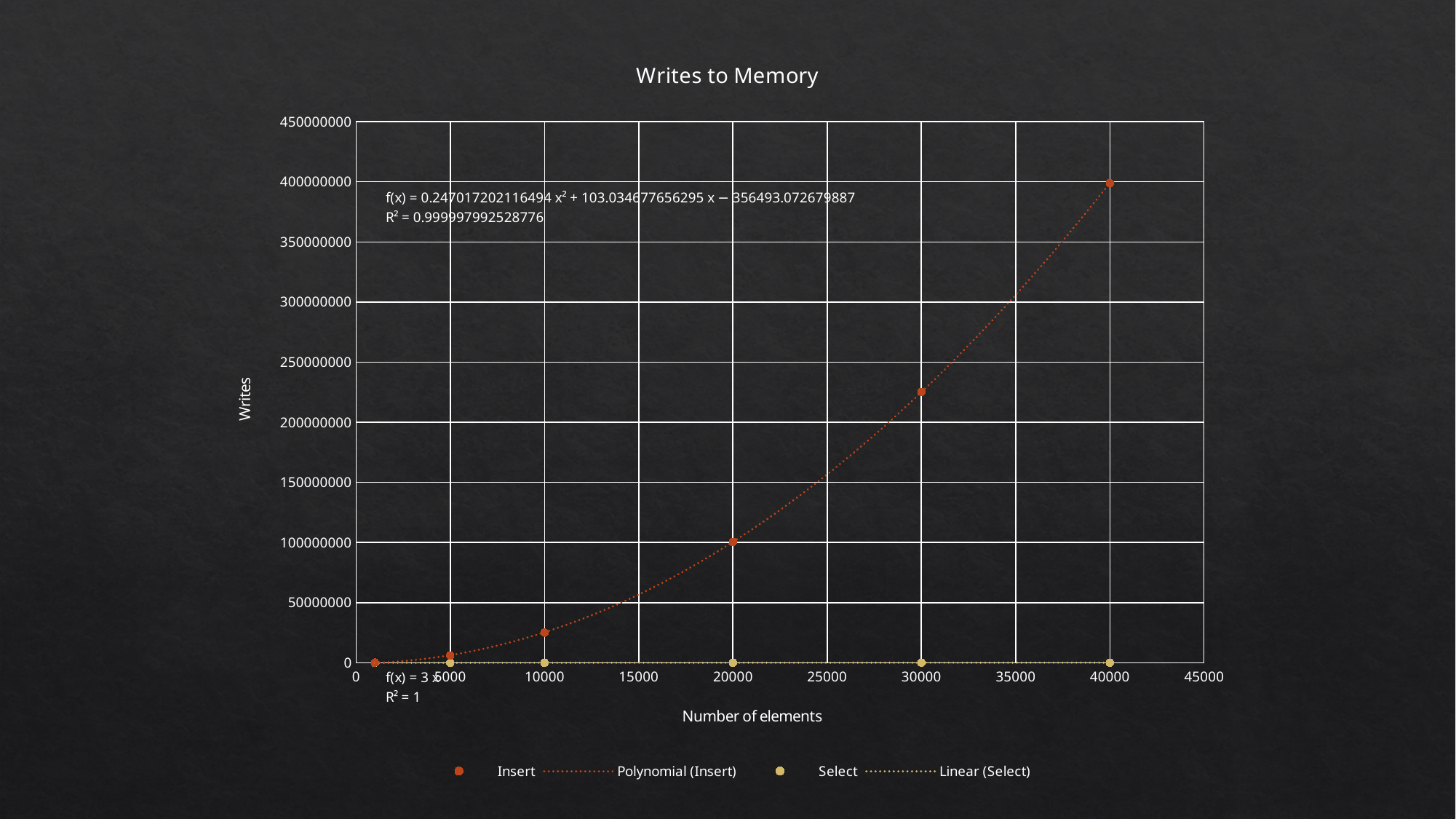
What R² value is shown for the polynomial trendline of the Insert series? 0.999997992528776 What is the title of the chart? Writes to Memory Is the Insert value at 20000 elements greater or less than 150000000? less What is the label of the x axis? Number of elements Is the Insert value at 10000 elements greater or less than 50000000? less At which number of elements does the Insert series reach its highest value? 40000 What kind of chart is shown on the slide? scatter chart Do the Insert values rise or fall as the number of elements increases? rise How many entries does the chart legend list? 4 Is the Insert value at 30000 elements greater or less than 200000000? greater At 40000 elements, which series has the larger number of writes, Insert or Select? Insert